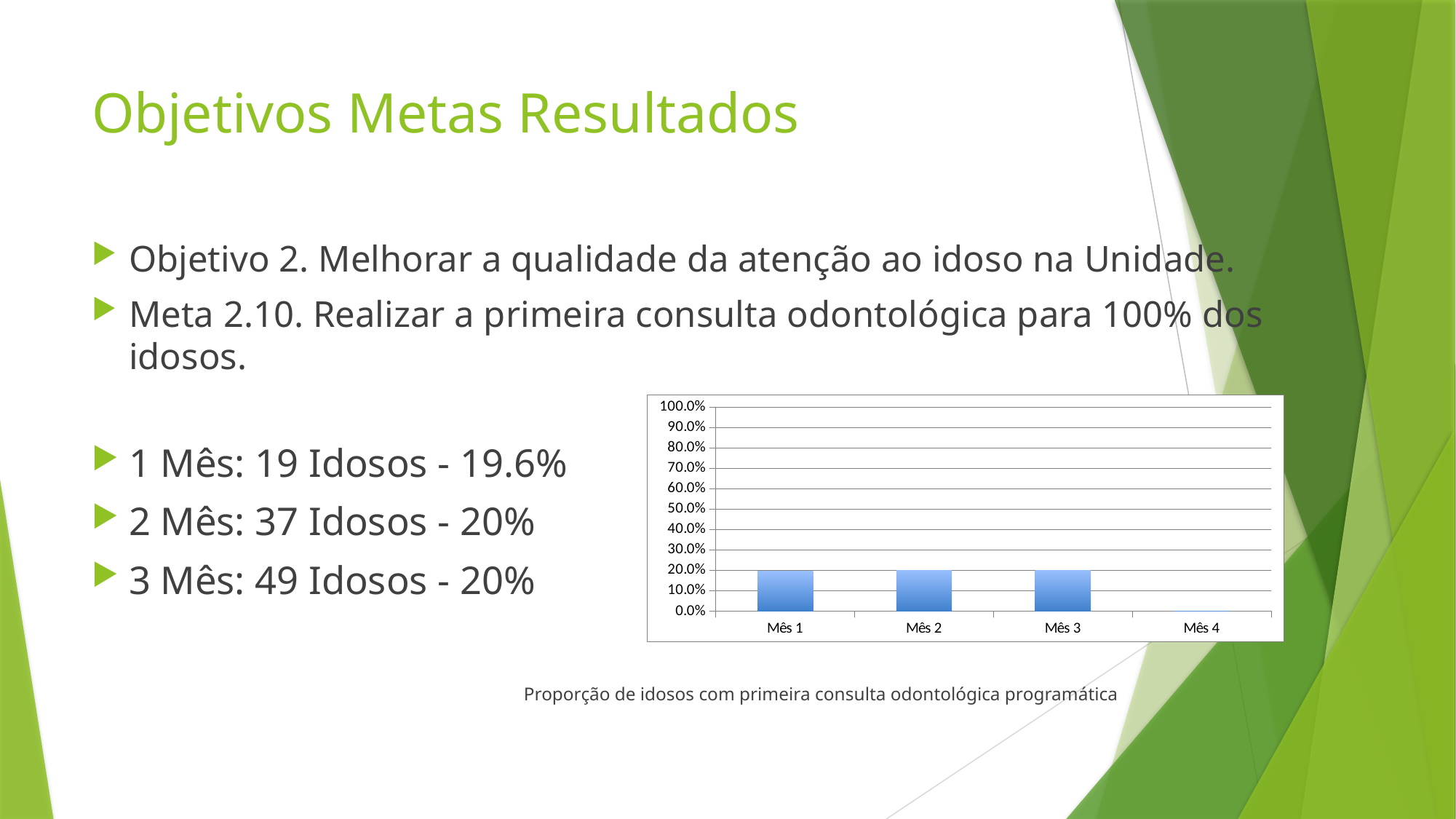
Is the value for Mês 1 greater or less than 50.0%? less Which category on the x axis has no bar plotted? Mês 4 Is the value for Mês 3 greater or less than 60.0%? less What kind of chart is shown on the slide? bar chart Is the value for Mês 2 greater or less than 10.0%? greater How many categories are shown on the x axis of the chart? 4 What is the value for Mês 3 in the chart? 20.0% What is the value for Mês 2 in the chart? 20.0% What is the label of the first category on the x axis? Mês 1 What is the highest value shown on the chart's y axis? 100.0%